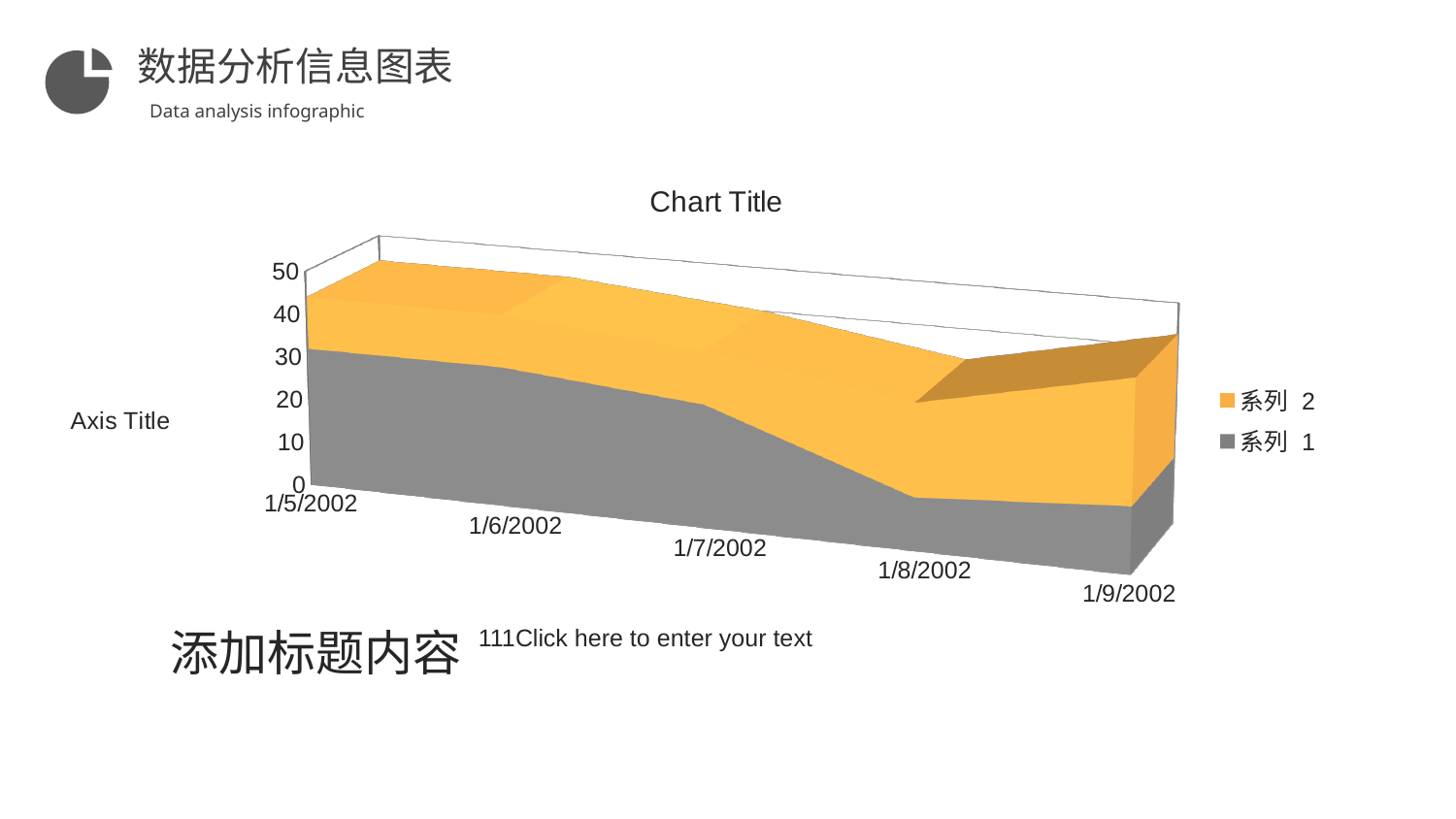
What is the first date shown on the x axis? 1/5/2002 Is the value of 系列 1 at 1/8/2002 greater or less than 20? less What kind of chart is shown on the slide? Area chart What are the two legend entries? 系列 2 and 系列 1 Which is larger for 系列 1: the value at 1/5/2002 or at 1/7/2002? 1/5/2002 How many series does the legend list? 2 What is the title of the chart? Chart Title What is the highest value shown on the vertical axis? 50 Is the value of 系列 1 at 1/5/2002 greater or less than 20? greater How many dates are shown along the x axis? 5 Does the value of 系列 1 rise or fall from 1/5/2002 to 1/8/2002? Fall